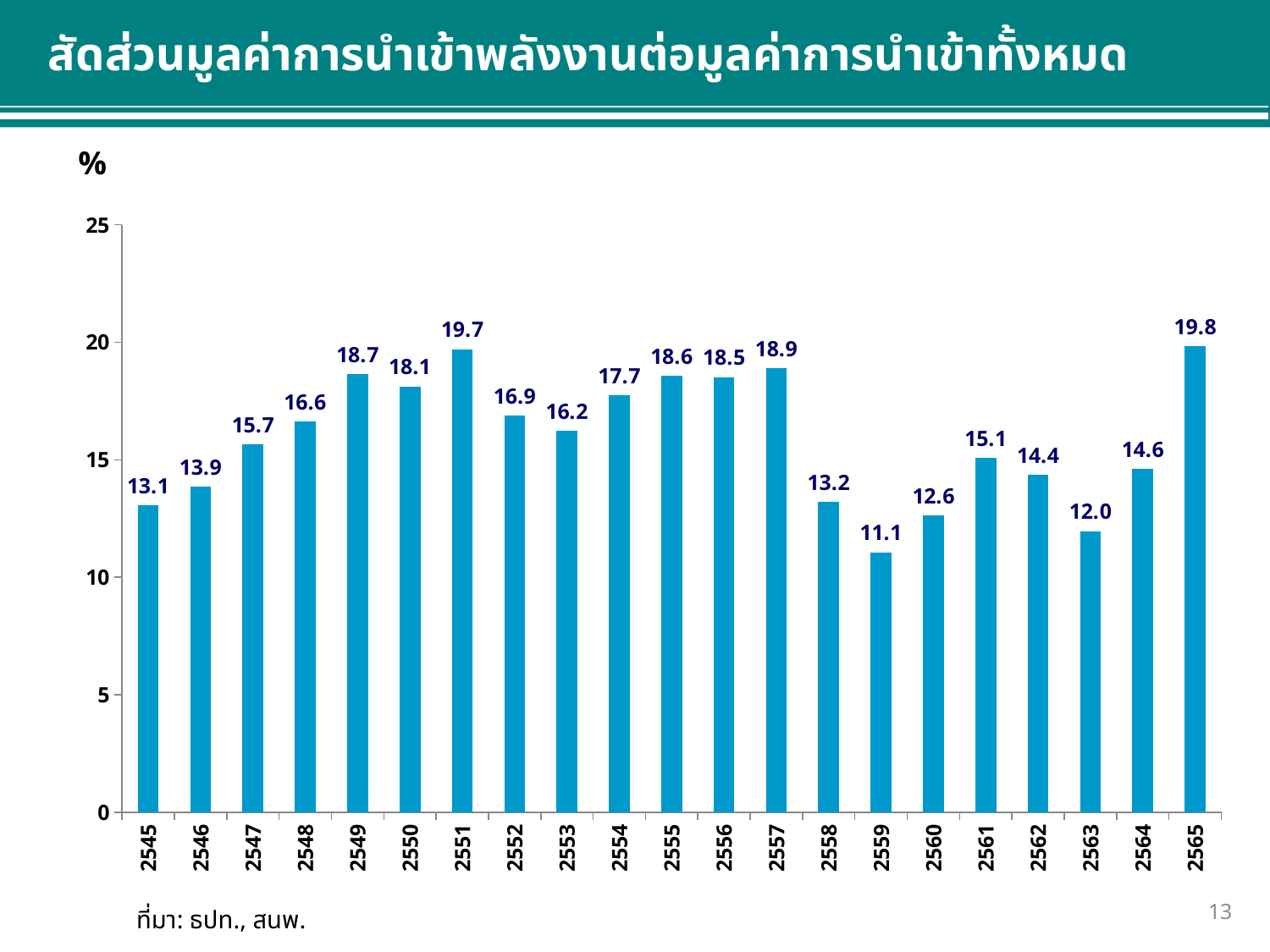
Which year has the lowest value? 2559 What is the value for 2565? 19.8 Is the value for 2563 greater or less than 15? less What is the value for 2551? 19.7 What is the value for 2545? 13.1 What is the value for 2559? 11.1 Which year has the highest value? 2565 What kind of chart is shown on the slide? bar chart Which is larger, the value for 2549 or the value for 2550? 2549 Do the values rise or fall from 2557 to 2559? fall What is the difference between the values for 2557 and 2558? 5.7 How many years are shown on the x axis? 21